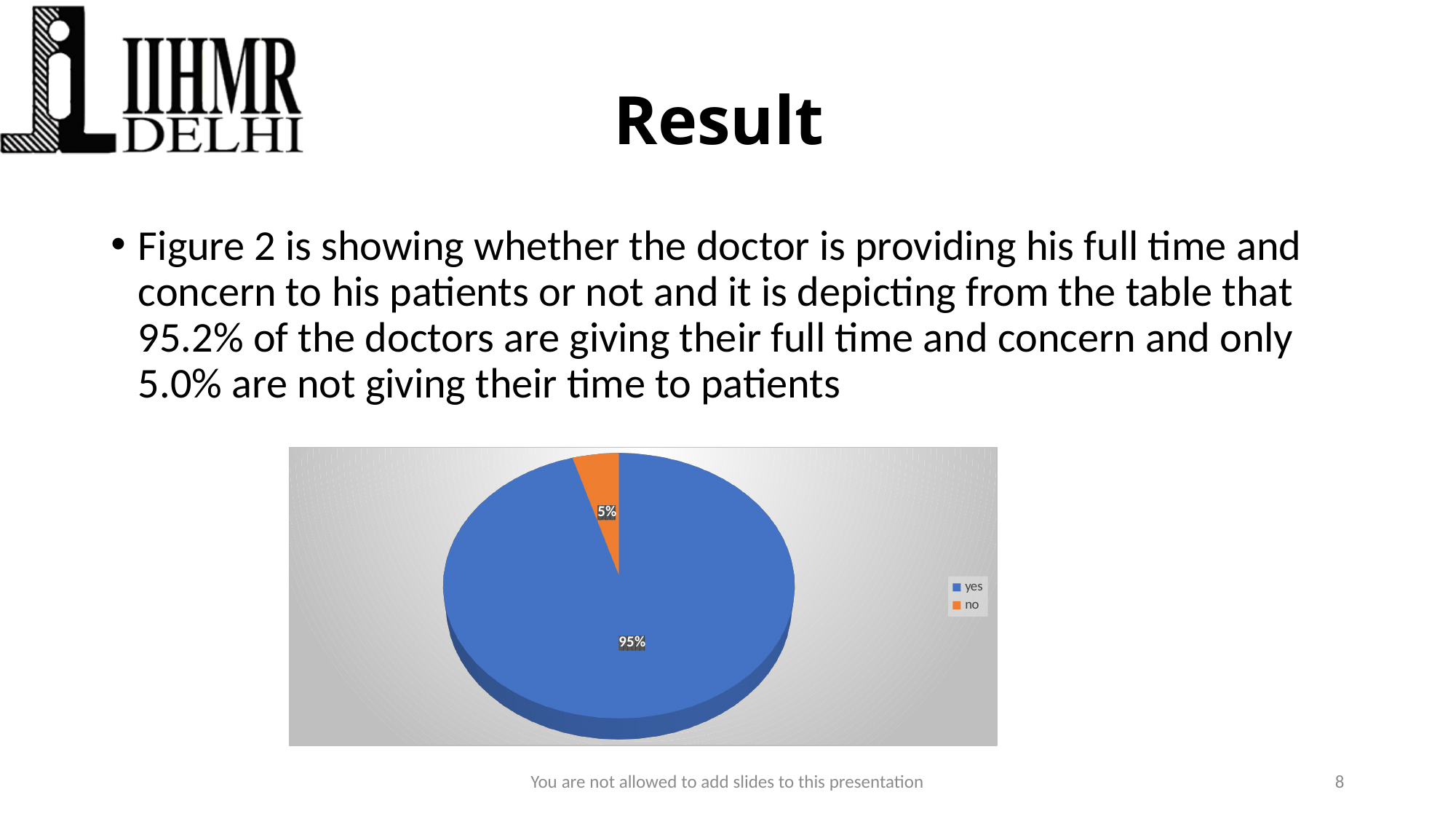
What percentage of the pie is labelled for the 'no' slice? 5% What percentage of the pie is labelled for the 'yes' slice? 95% What is the difference in percentage points between the 'yes' and 'no' slices? 90 What kind of chart is shown on the slide? pie chart What colour is the 'yes' slice in the pie chart? blue Which slice is larger, 'yes' or 'no'? yes Which slice of the pie chart is the smallest? no What share of the pie does the 'no' slice represent? 5% What colour is the 'no' slice in the pie chart? orange How many slices does the pie chart have? 2 How many entries does the legend list? 2 Which slice of the pie chart is the largest? yes